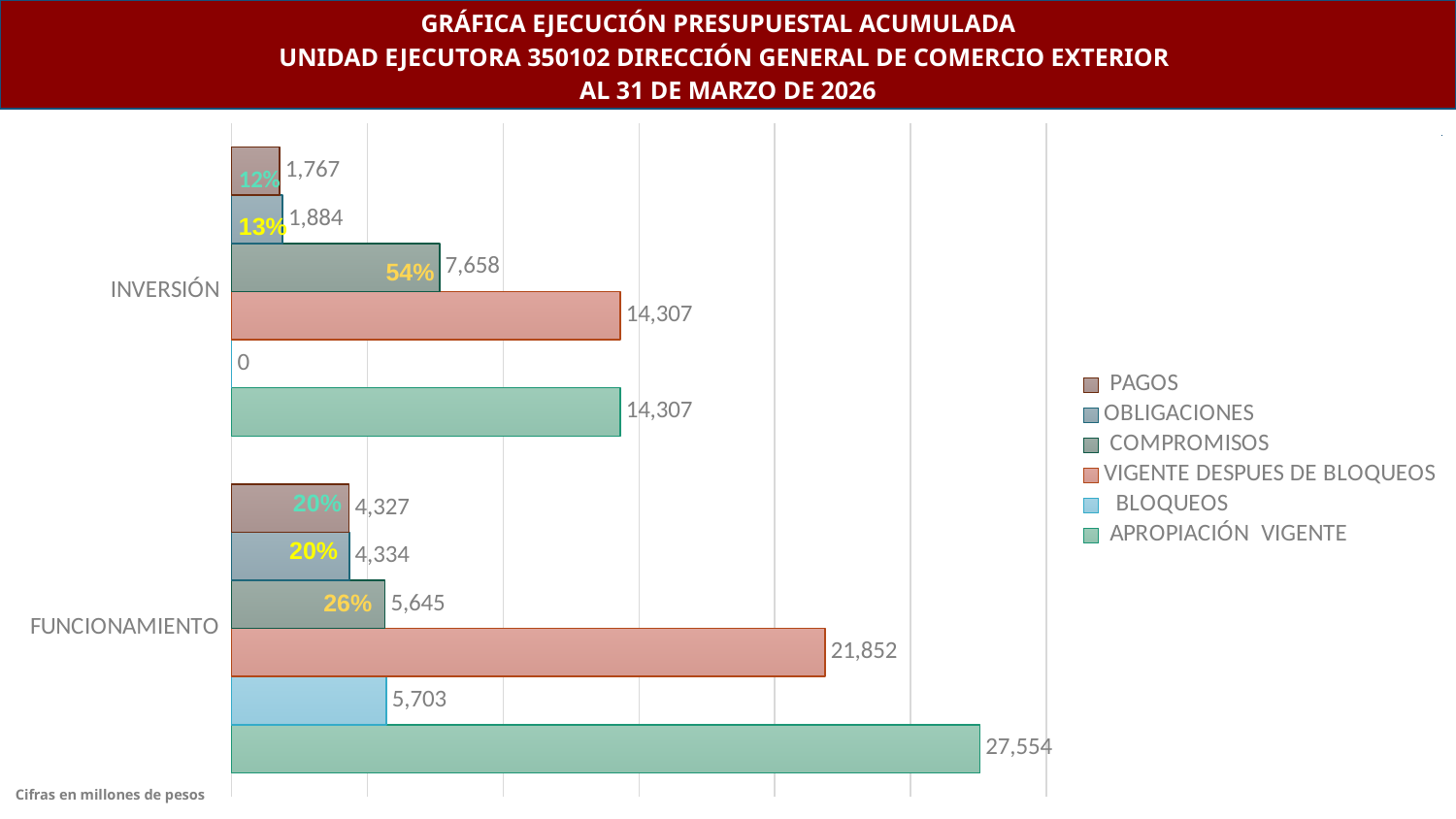
How many series does the legend list? 6 What is the BLOQUEOS value for FUNCIONAMIENTO? 5,703 Which is larger, the OBLIGACIONES value for FUNCIONAMIENTO or the COMPROMISOS value for INVERSIÓN? COMPROMISOS value for INVERSIÓN What is the APROPIACIÓN VIGENTE value for FUNCIONAMIENTO? 27,554 What is the COMPROMISOS value for INVERSIÓN? 7,658 What kind of chart is shown on the slide? Bar chart Which series has the highest value for FUNCIONAMIENTO? APROPIACIÓN VIGENTE What is the VIGENTE DESPUES DE BLOQUEOS value for FUNCIONAMIENTO? 21,852 What is the difference between the APROPIACIÓN VIGENTE and VIGENTE DESPUES DE BLOQUEOS values for FUNCIONAMIENTO? 5,702 What is the PAGOS value for INVERSIÓN? 1,767 What is the BLOQUEOS value for INVERSIÓN? 0 Which series has the lowest value for INVERSIÓN? BLOQUEOS